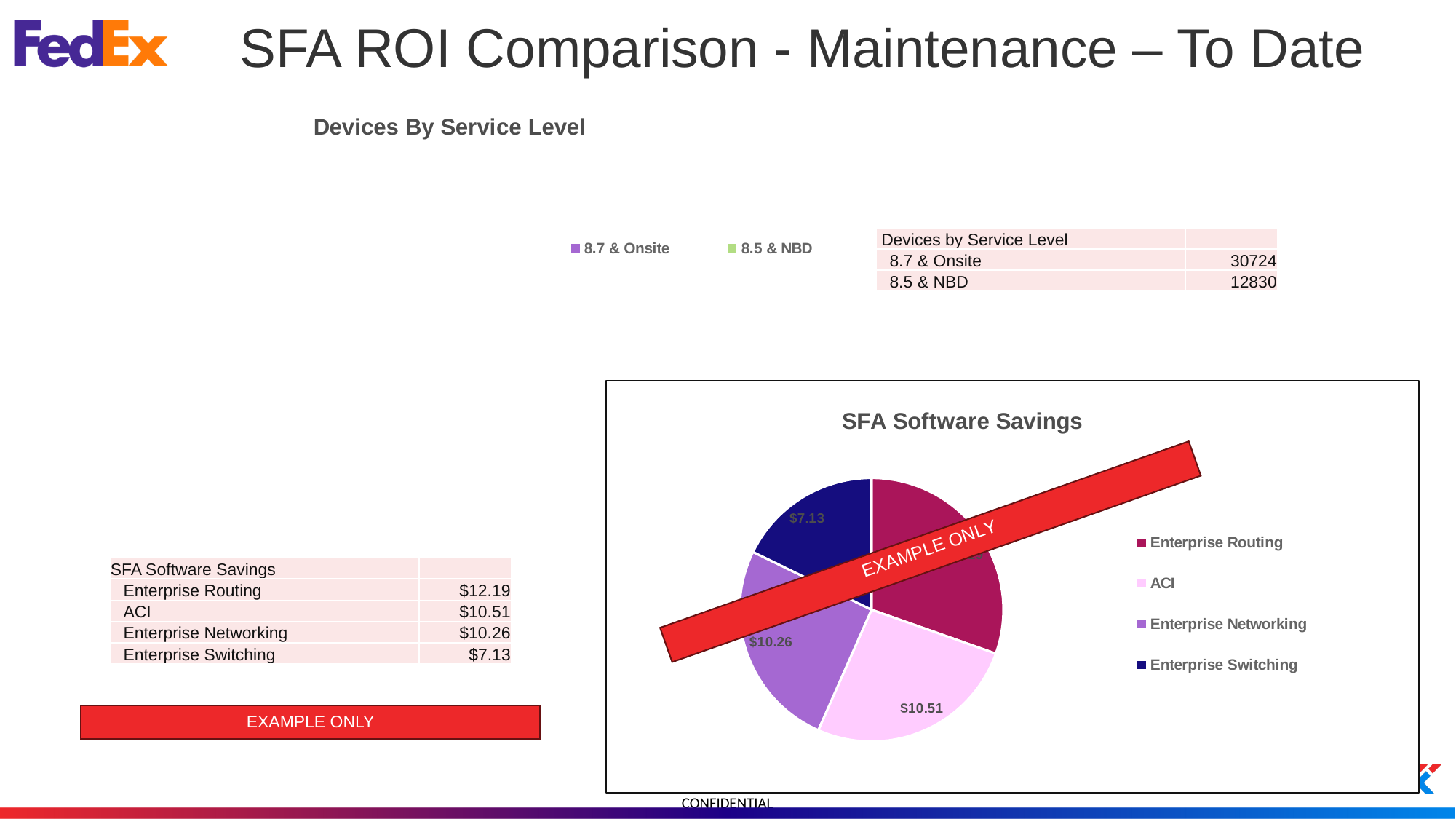
In the SFA Software Savings chart, what is the value for Enterprise Routing? $12.19 In the SFA Software Savings chart, which category has the largest slice? Enterprise Routing In the SFA Software Savings chart, what is the value for Enterprise Switching? $7.13 In the SFA Software Savings chart, what is the value for ACI? $10.51 In the SFA Software Savings chart, what is the difference between the values for ACI and Enterprise Networking? $0.25 In the SFA Software Savings chart, which category has the smallest slice? Enterprise Switching What kind of chart is the SFA Software Savings chart? pie chart What two entries does the legend of the Devices By Service Level chart list? 8.7 & Onsite and 8.5 & NBD In the SFA Software Savings chart, what is the value for Enterprise Networking? $10.26 In the SFA Software Savings chart, which is larger, the value for ACI or the value for Enterprise Networking? ACI In the SFA Software Savings chart, what is the difference between the values for Enterprise Routing and Enterprise Switching? $5.06 In the SFA Software Savings chart, how many slices does the pie have? 4